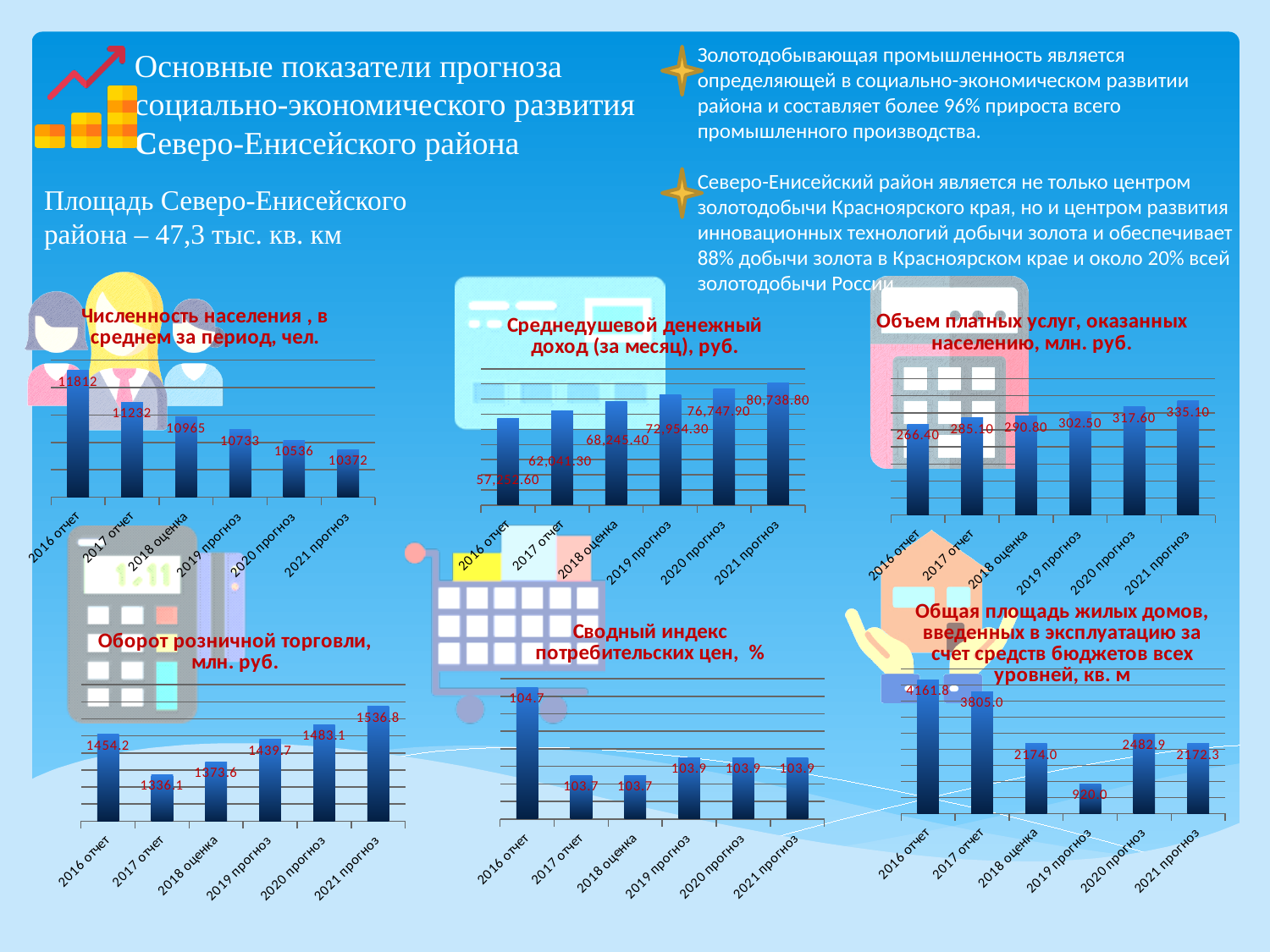
How many categories are shown in the chart 'Объем платных услуг, оказанных населению, млн. руб.'? 6 In the chart 'Оборот розничной торговли, млн. руб.', which category has the lowest value? 2017 отчет In the chart 'Среднедушевой денежный доход (за месяц), руб.', which category has the highest value? 2021 прогноз In the chart 'Численность населения, в среднем за период, чел.', what is the difference between the 2016 отчет and 2021 прогноз values? 1440 In the chart 'Численность населения, в среднем за период, чел.', what is the value for 2016 отчет? 11812 In the chart 'Общая площадь жилых домов, введенных в эксплуатацию за счет средств бюджетов всех уровней, кв. м', which category has the lowest value? 2019 прогноз In the chart 'Среднедушевой денежный доход (за месяц), руб.', what is the value for 2021 прогноз? 80,738.80 In the chart 'Численность населения, в среднем за период, чел.', do the values rise or fall from 2016 to 2021? fall What type of chart is used for 'Общая площадь жилых домов, введенных в эксплуатацию за счет средств бюджетов всех уровней, кв. м'? bar chart In the chart 'Оборот розничной торговли, млн. руб.', what is the value for 2020 прогноз? 1483.1 In the chart 'Объем платных услуг, оказанных населению, млн. руб.', what is the value for 2019 прогноз? 302.50 In the chart 'Сводный индекс потребительских цен, %', what is the value for 2016 отчет? 104.7